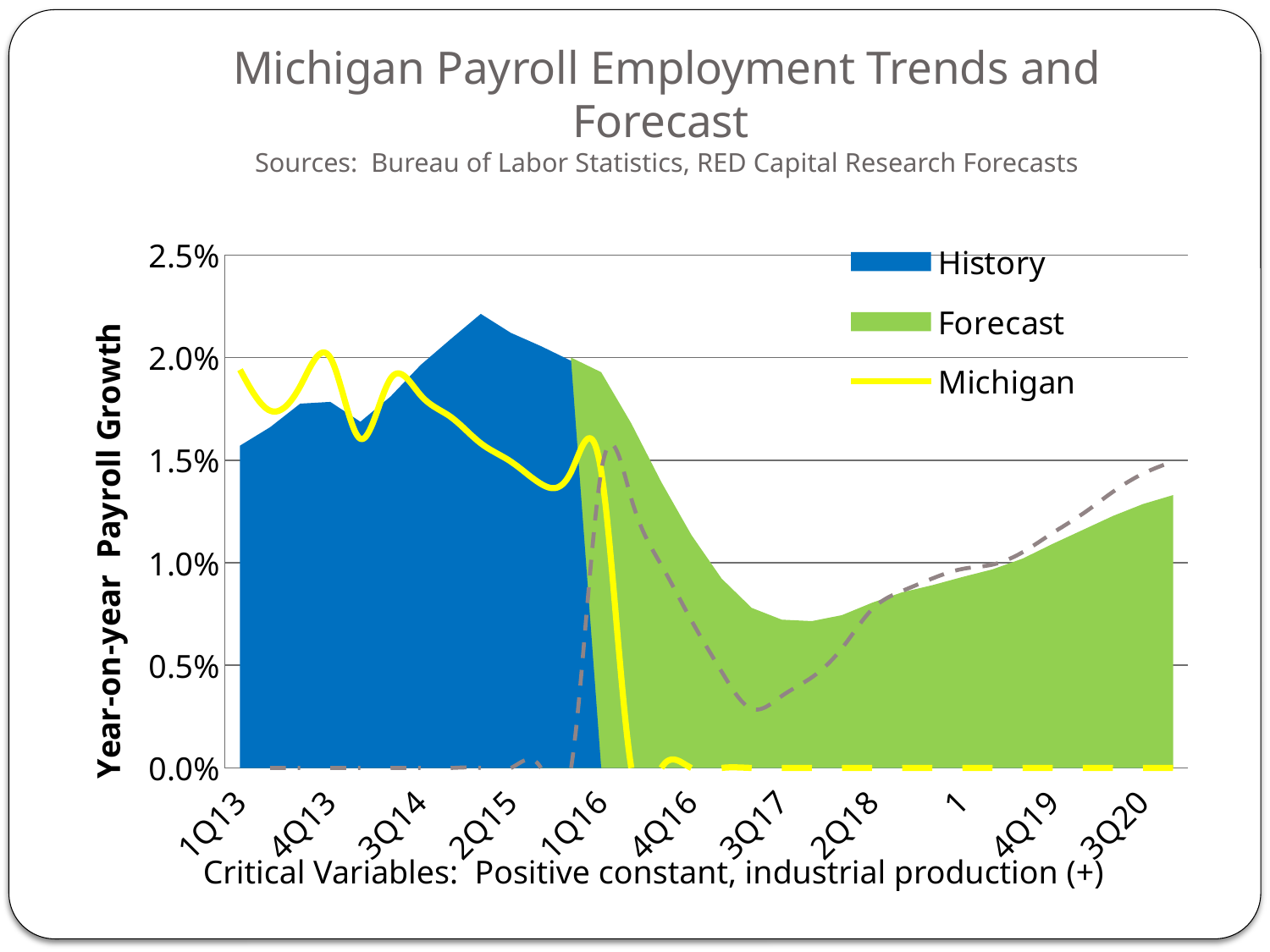
Which is larger: the History value at 2Q15 or the Forecast value at 3Q17? History value at 2Q15 Is the Michigan line value at 4Q16 greater or less than 0.5%? less Is the Forecast value at 3Q17 greater or less than 1.0%? less How many series does the legend list? 3 What is the title of the chart? Michigan Payroll Employment Trends and Forecast Is the Forecast value at 3Q20 greater or less than 1.0%? greater What kind of chart is shown on the slide? Combination area and line chart Does the Forecast series rise or fall between 1Q16 and 3Q17? fall Does the Forecast series rise or fall between 3Q17 and 3Q20? rise What is the label on the vertical axis? Year-on-year Payroll Growth